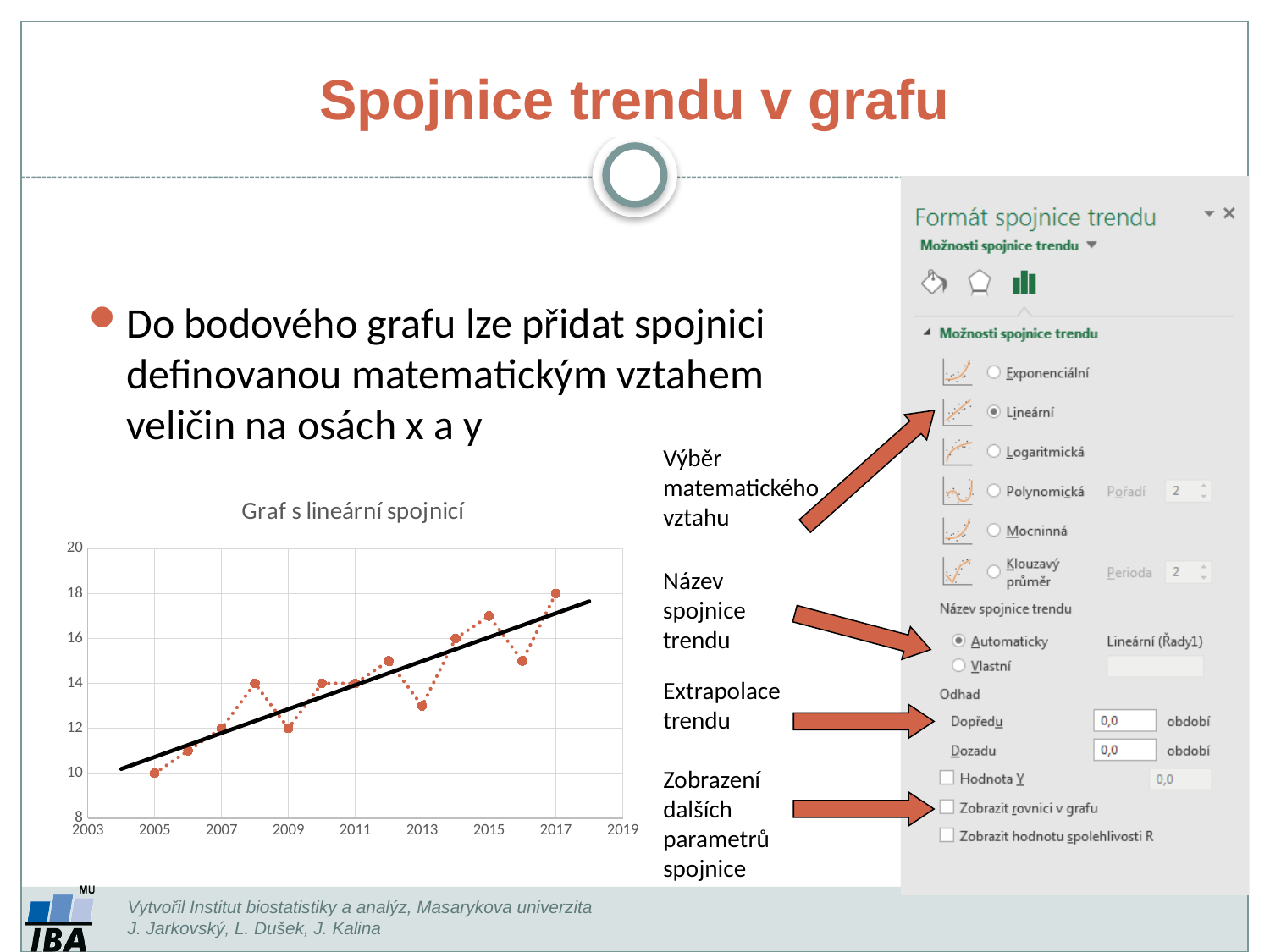
Is the value for 2013 greater or less than 14? less Which is larger, the data point for 2011 or the data point for 2007? 2011 Do the data points generally rise or fall from 2005 to 2017? rise What kind of chart is shown on the slide? scatter chart with a linear trendline What is the value of the data point for 2011? 14 What is the value of the data point for 2017? 18 What is the title of the chart on the slide? Graf s lineární spojnicí Which year has the lowest data point? 2005 Which year has the highest data point? 2017 What is the difference between the data point for 2017 and the data point for 2005? 8 What is the value of the data point for 2005? 10 What is the value of the data point for 2007? 12